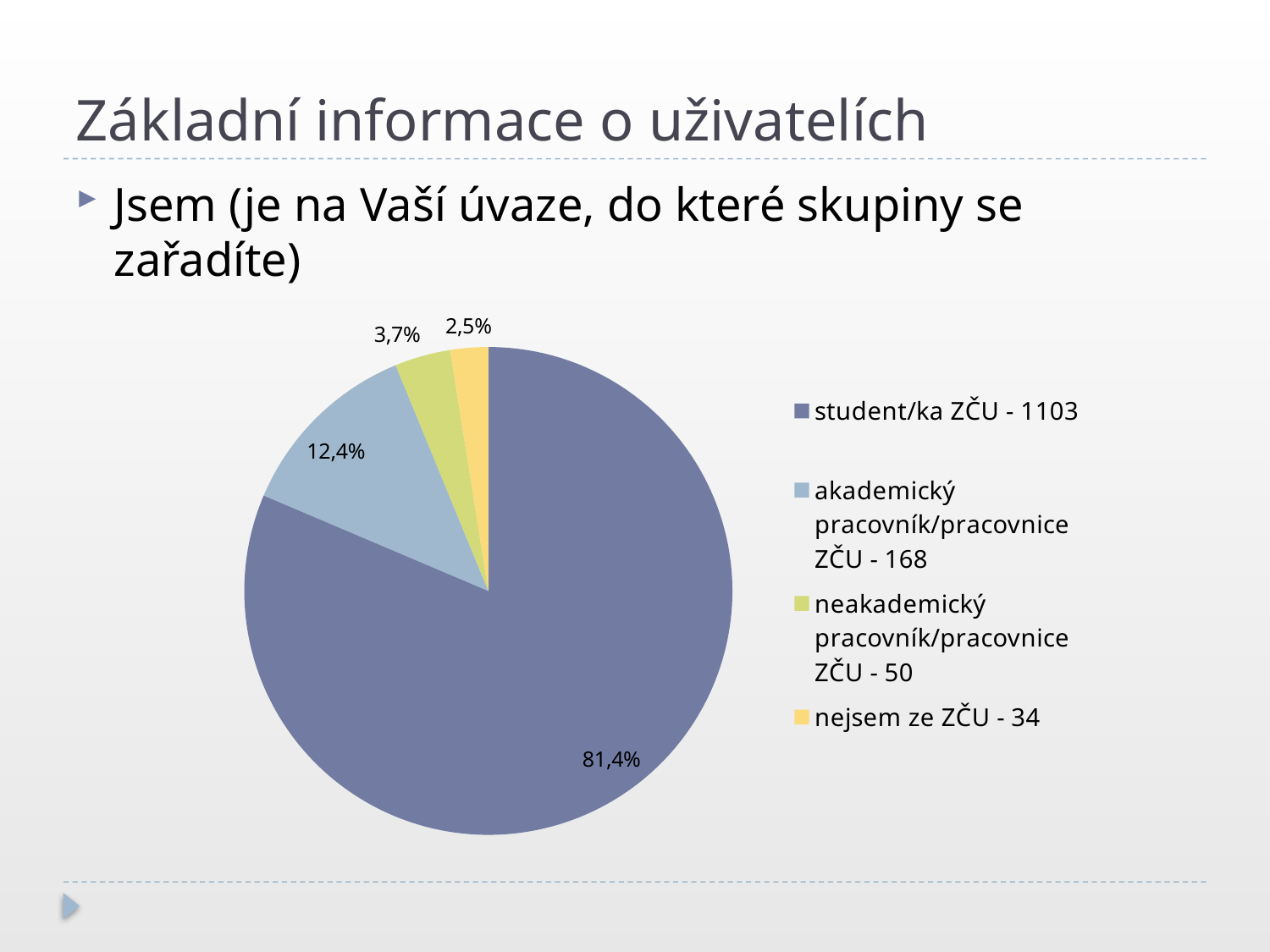
What percentage is shown for nejsem ze ZČU? 2,5% What percentage is shown for neakademický pracovník/pracovnice ZČU? 3,7% Which is larger: the slice for akademický pracovník/pracovnice ZČU or the slice for neakademický pracovník/pracovnice ZČU? akademický pracovník/pracovnice ZČU What percentage is shown for akademický pracovník/pracovnice ZČU? 12,4% Which category has the smallest slice of the pie? nejsem ze ZČU What is the difference between the number of respondents in the student/ka ZČU group (1103) and the akademický pracovník/pracovnice ZČU group (168), as given in the legend? 935 According to the legend, how many respondents are in the student/ka ZČU group? 1103 What kind of chart is shown on the slide? pie chart What colour is the slice for nejsem ze ZČU? yellow What share of the pie does the slice for student/ka ZČU represent? 81,4% How many slices does the pie chart have? 4 Which category has the largest slice of the pie? student/ka ZČU